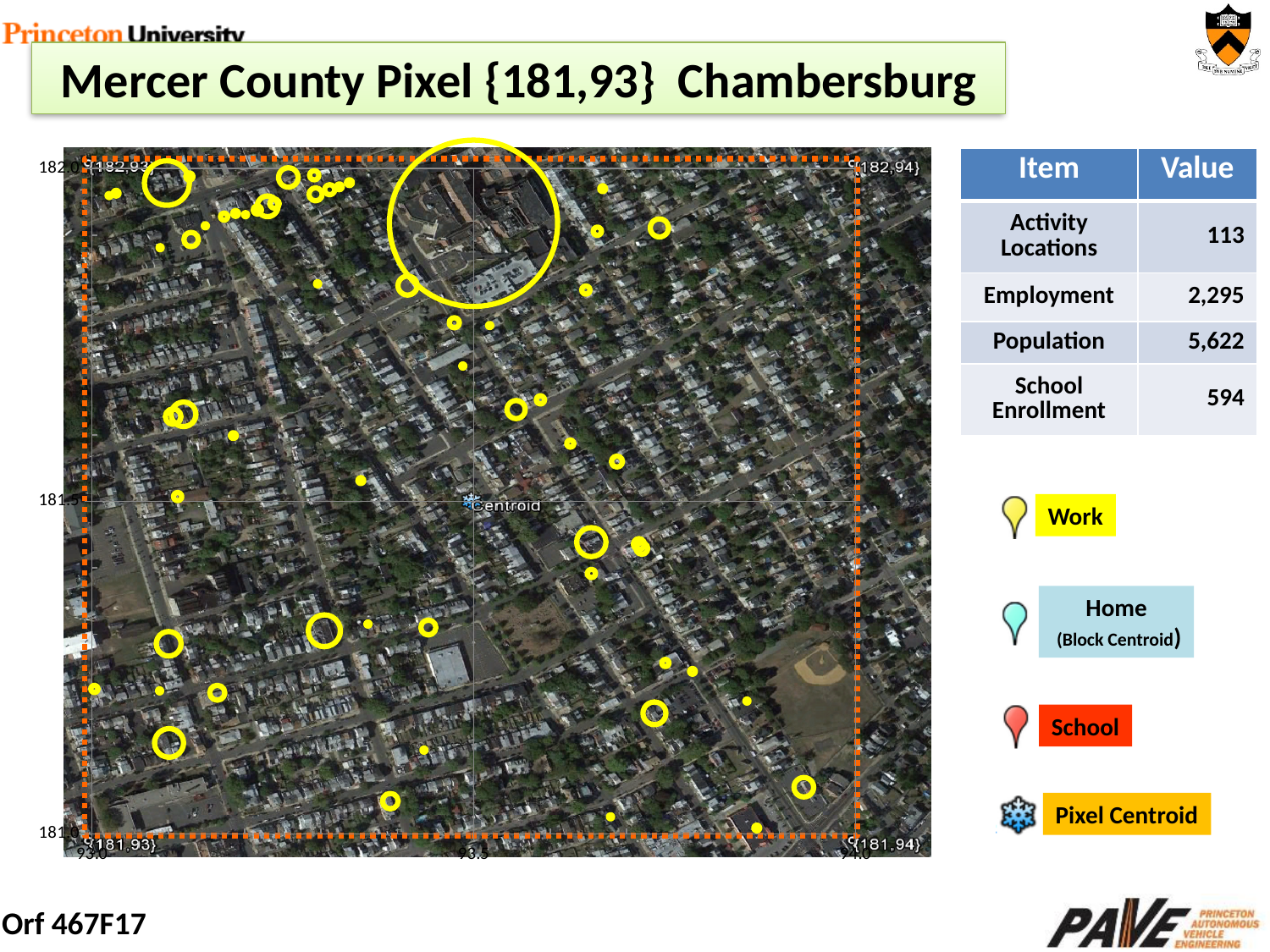
Which legend entry is shown with a yellow marker? Work How many items are listed in the table? 4 Which item in the table has the lowest value? Activity Locations What is the value for Employment in the table? 2,295 What is the title of the slide? Mercer County Pixel {181,93} Chambersburg Which is larger, the Employment value or the School Enrollment value? Employment What is the value for School Enrollment in the table? 594 What is the value for Population in the table? 5,622 How many entries does the map legend list? 4 Which item in the table has the highest value? Population What is the value for Activity Locations in the table? 113 What is the difference between the Population value and the Employment value? 3,327